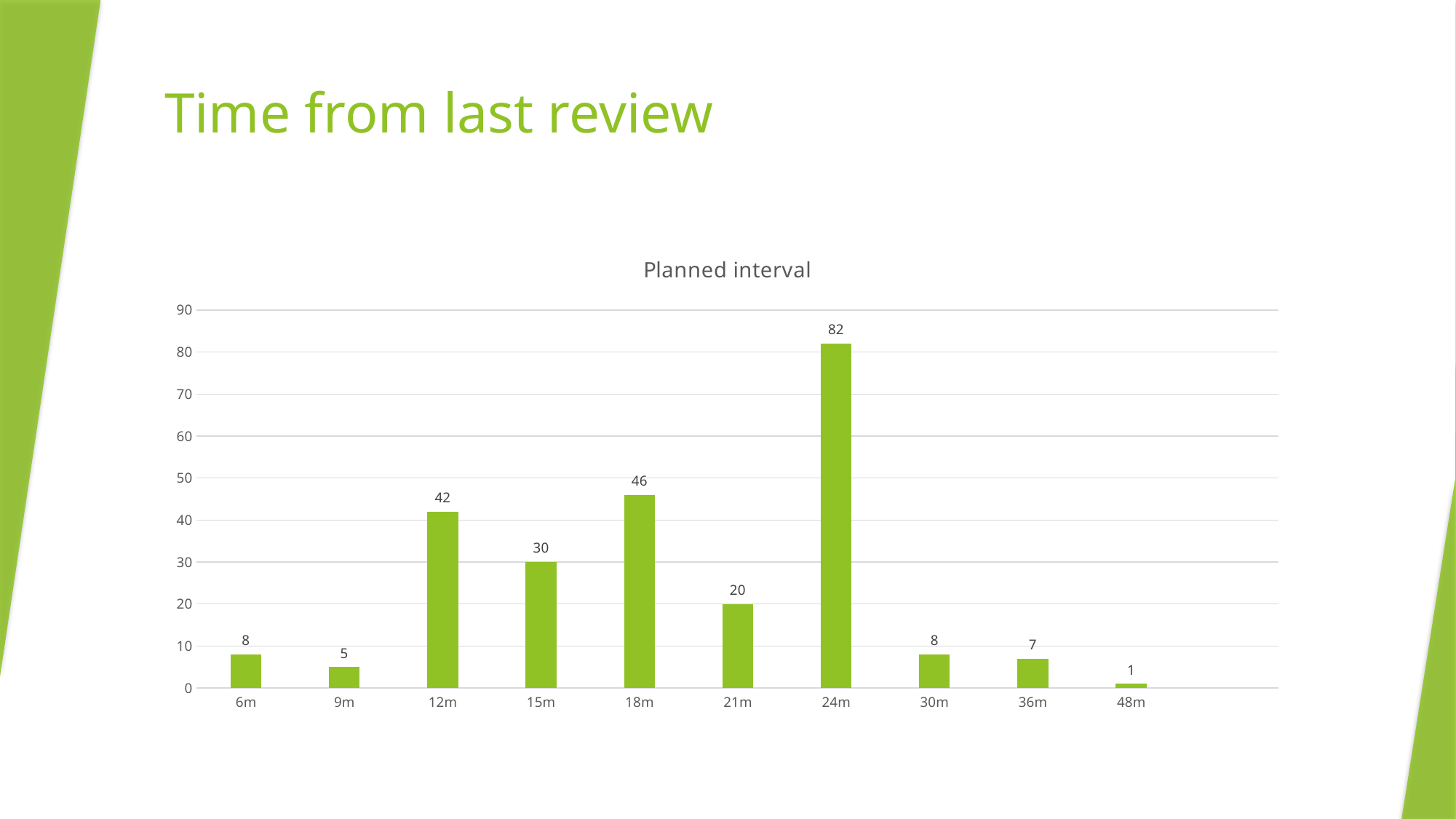
What is the value for the 24m planned interval? 82 Which planned interval has the highest value? 24m What is the difference between the values for 24m and 18m? 36 What is the value for the 21m planned interval? 20 What is the difference between the values for 12m and 15m? 12 Which has a larger value, 18m or 15m? 18m What is the value for the 12m planned interval? 42 How many planned interval categories are shown on the x axis? 10 What is the title of the chart? Planned interval What kind of chart is shown on the slide? Bar chart Which planned interval has the lowest value? 48m Which has a larger value, 6m or 9m? 6m